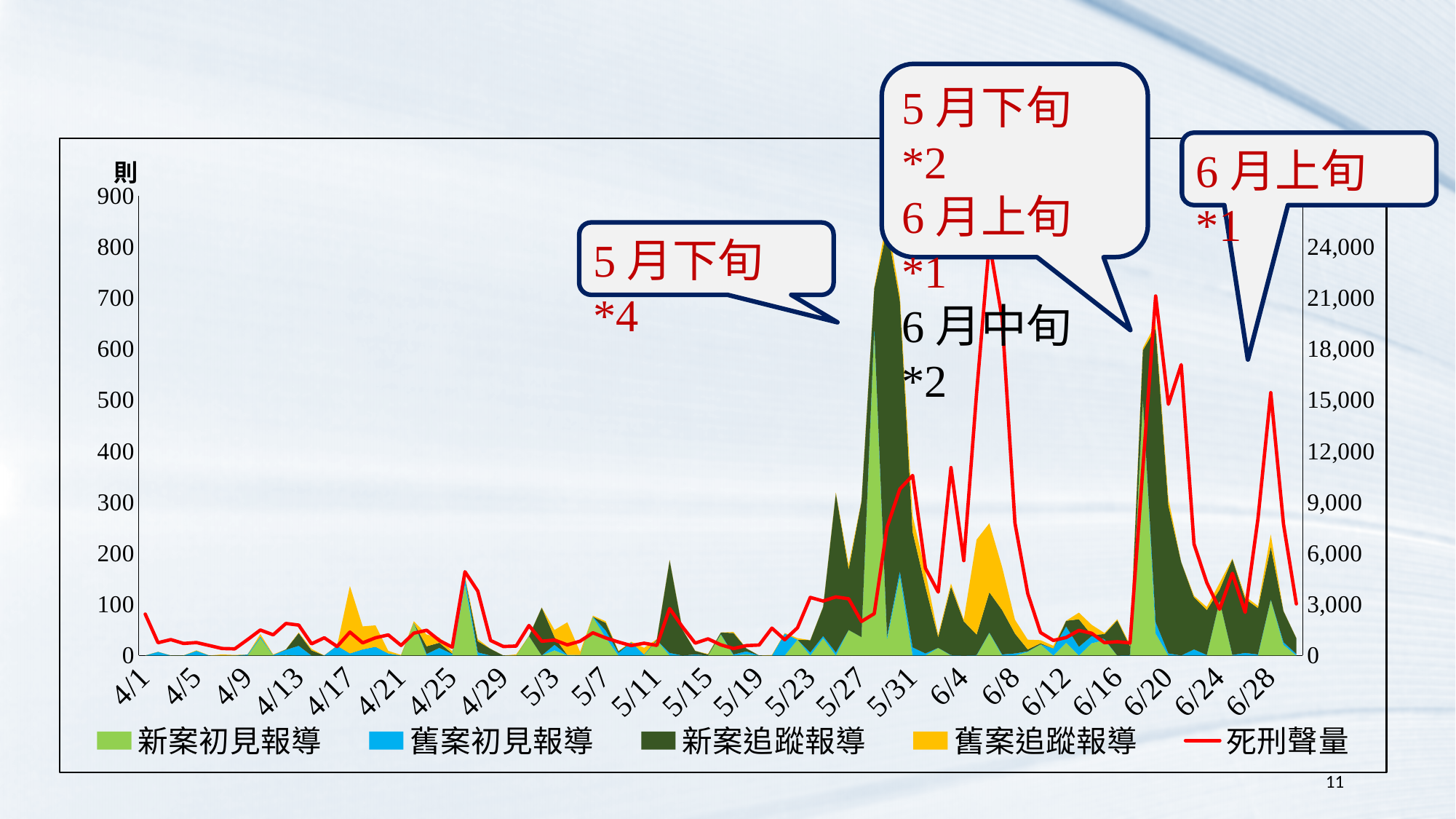
Which series is drawn as a red line rather than a filled area? 死刑聲量 Is the highest peak of the stacked areas (around 5/29) greater or less than 700 on the left axis? greater Is the stacked total at 4/1 greater or less than 100 on the left axis? less Is the value of 死刑聲量 at 4/5 greater or less than 3,000 on the right axis? less How many series does the legend list? 5 How many date labels are shown along the x axis? 23 What is the unit label shown above the left vertical axis? 則 What kind of chart is this? Stacked area chart with a line series